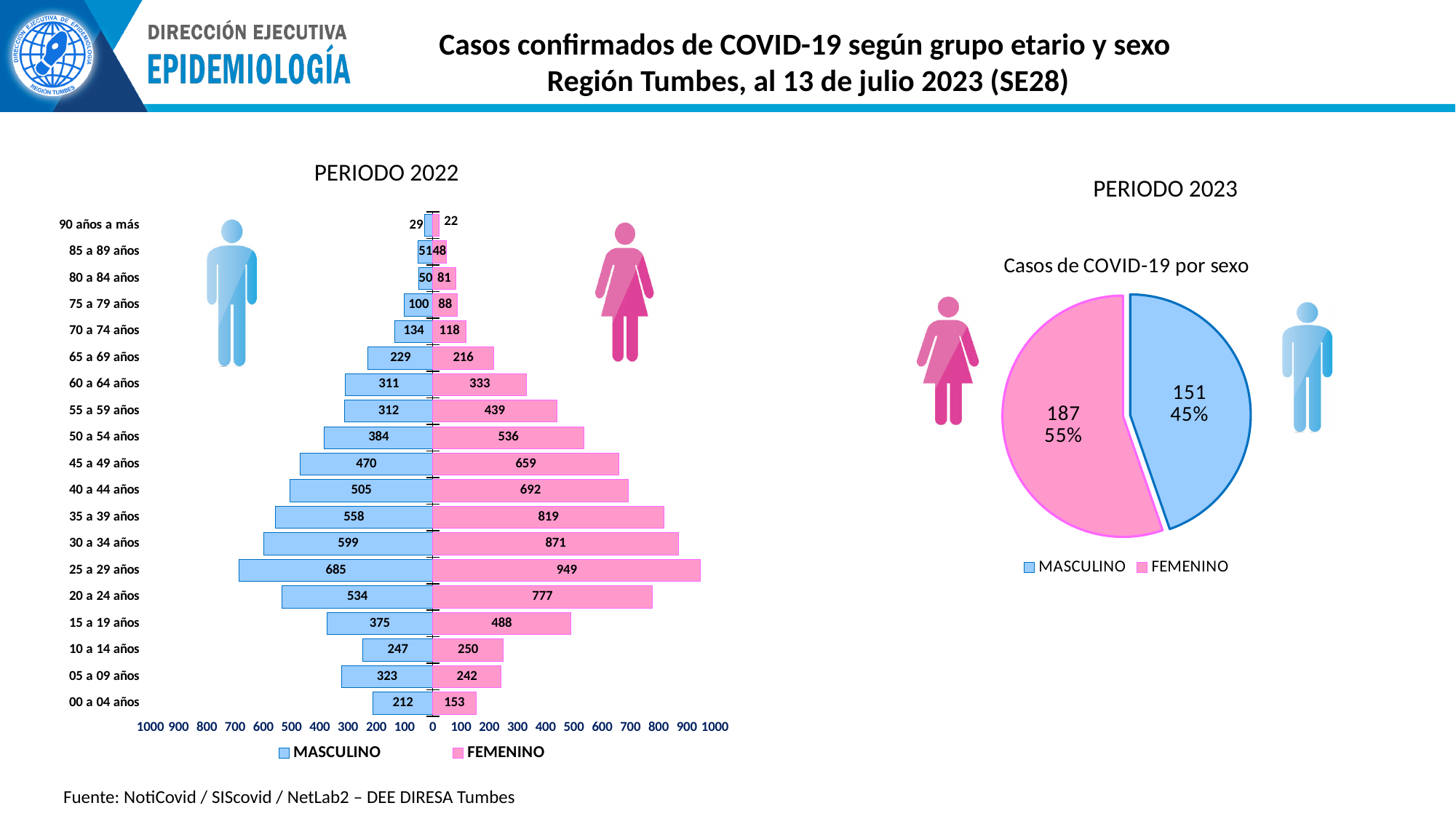
In the PERIODO 2023 pie chart, what share of cases is FEMENINO? 55% In the PERIODO 2023 pie chart, how many MASCULINO cases are shown? 151 In the PERIODO 2022 chart, which age group has the lowest FEMENINO value? 90 años a más In the PERIODO 2022 chart, which is larger for the 05 a 09 años group, MASCULINO or FEMENINO? MASCULINO In the PERIODO 2022 chart, how many FEMENINO cases are shown for the 30 a 34 años group? 871 In the PERIODO 2022 chart, how many MASCULINO cases are shown for the 25 a 29 años group? 685 How many series does the legend of the PERIODO 2022 chart list? 2 In the PERIODO 2022 chart, which age group has the highest FEMENINO value? 25 a 29 años In the PERIODO 2022 chart, what is the difference between the FEMENINO and MASCULINO values for the 35 a 39 años group? 261 How many age groups are shown in the PERIODO 2022 chart? 19 What kind of chart is the PERIODO 2022 chart? Bar chart What is the total number of cases shown in the PERIODO 2023 pie chart? 338